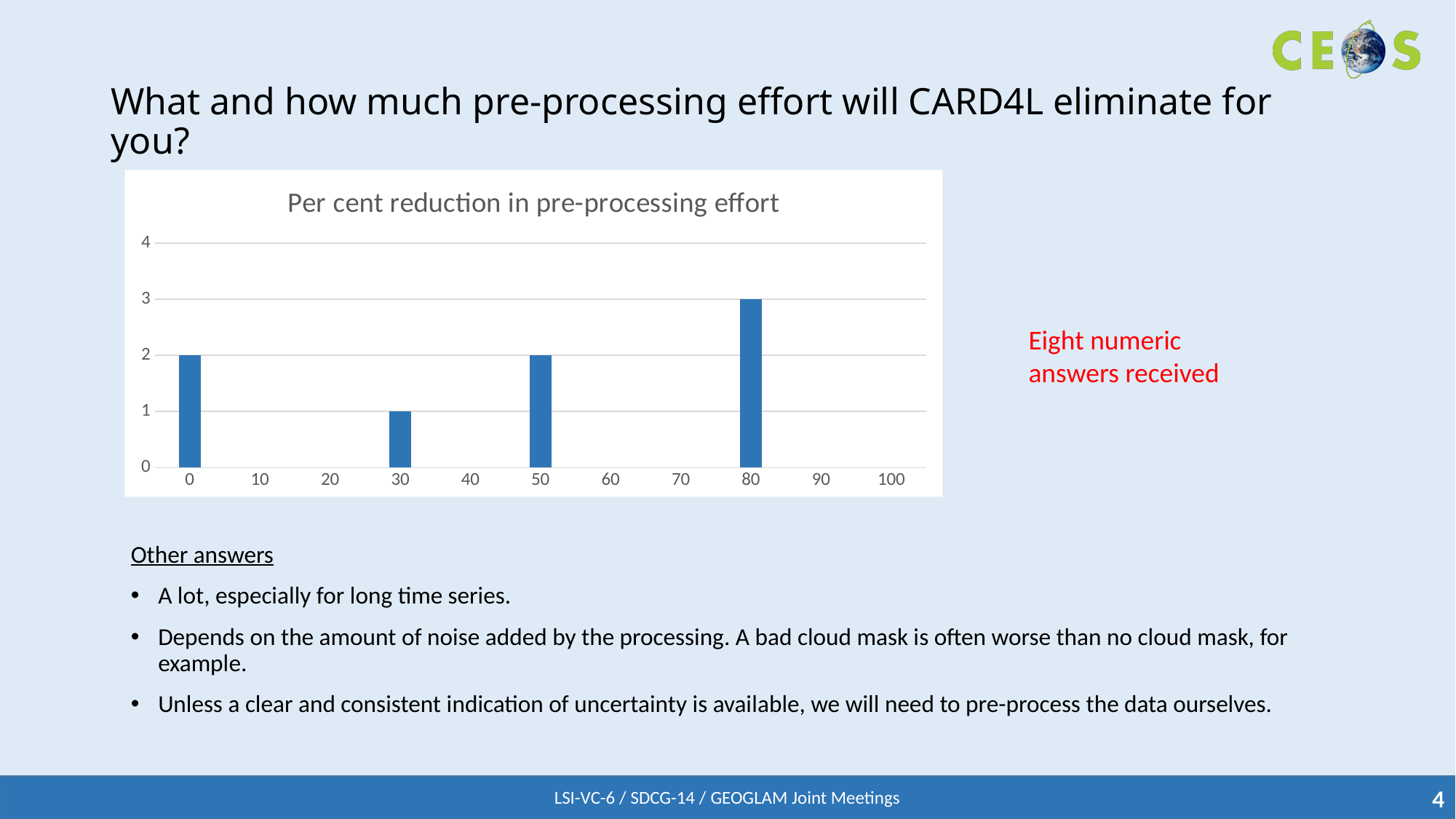
What is the title of the chart? Per cent reduction in pre-processing effort What is the difference between the values for the 80 and 30 categories? 2 What is the value for the 0 category in the chart? 2 How many bars are plotted in the chart? 4 What kind of chart is shown on the slide? bar chart Which category has the highest bar in the chart? 80 Among the categories that have a bar, which one has the lowest value? 30 Which has the larger value, the 50 category or the 30 category? 50 What is the value for the 80 category in the chart? 3 What is the value for the 30 category in the chart? 1 How many categories are labelled on the x axis of the chart? 11 Is the value for the 80 category greater or less than 2? greater